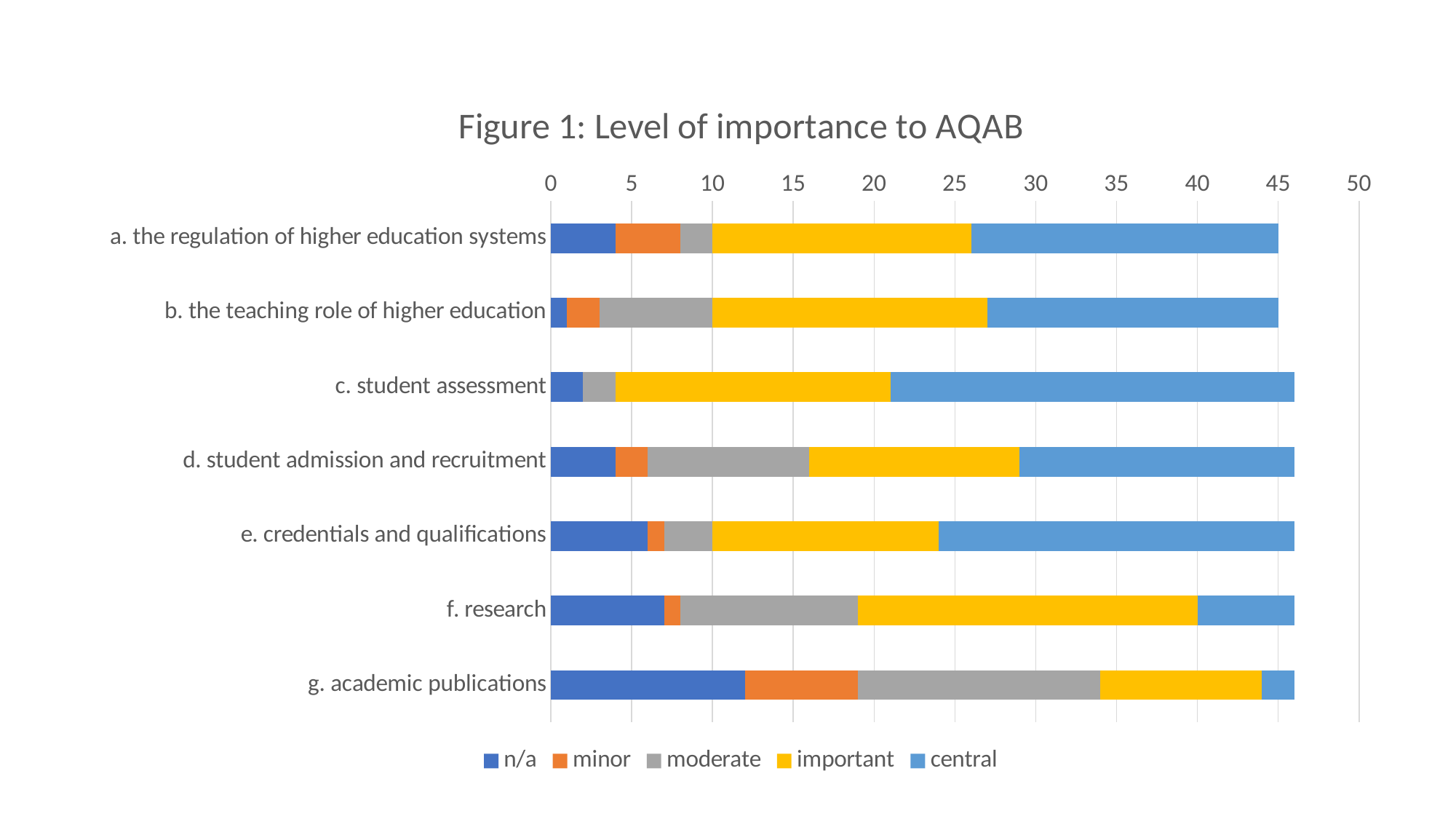
Which is larger: the 'central' segment for a. the regulation of higher education systems or the 'central' segment for g. academic publications? a. the regulation of higher education systems Is the 'n/a' value for g. academic publications greater or less than 10? greater What is the title of the chart? Figure 1: Level of importance to AQAB Is the 'central' value for g. academic publications greater or less than 5? less Which series is shown in yellow in the legend? important Is the 'n/a' value for b. the teaching role of higher education greater or less than 5? less What kind of chart is shown on the slide? stacked bar chart Which category has the largest 'n/a' segment? g. academic publications Which category has the smallest 'central' segment? g. academic publications How many series does the legend list? 5 How many categories are plotted in the chart? 7